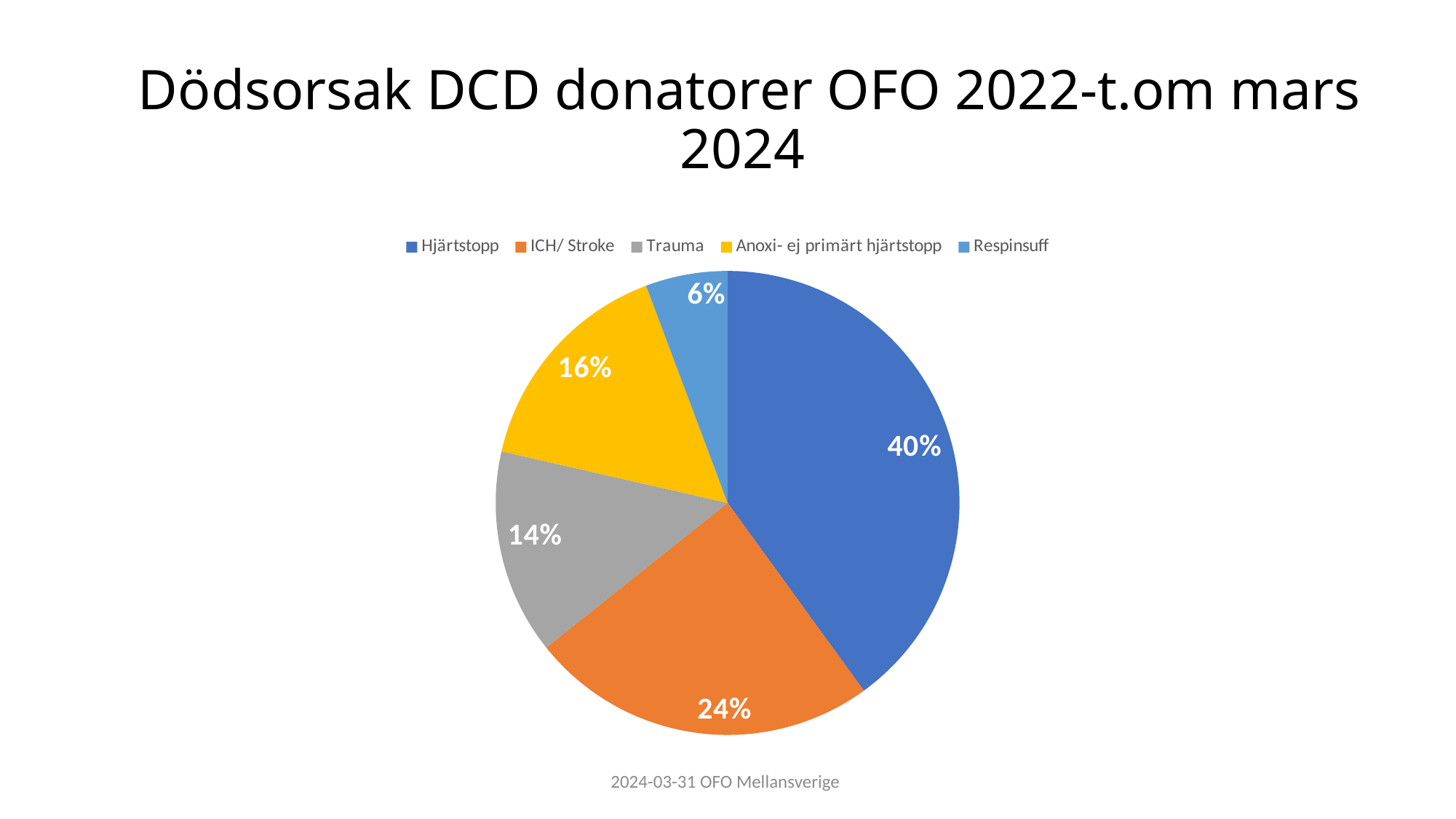
What kind of chart is shown on the slide? pie chart What is the title of the chart on the slide? Dödsorsak DCD donatorer OFO 2022-t.om mars 2024 What share of the pie does Respinsuff account for? 6% How many categories does the pie chart show? 5 What share of the pie does ICH/ Stroke account for? 24% Which category has the largest slice of the pie? Hjärtstopp Which category has the smallest slice of the pie? Respinsuff What share of the pie does Trauma account for? 14% What is the difference in percentage points between Hjärtstopp and ICH/ Stroke? 16 Which is larger, the share for Trauma or the share for Anoxi- ej primärt hjärtstopp? Anoxi- ej primärt hjärtstopp